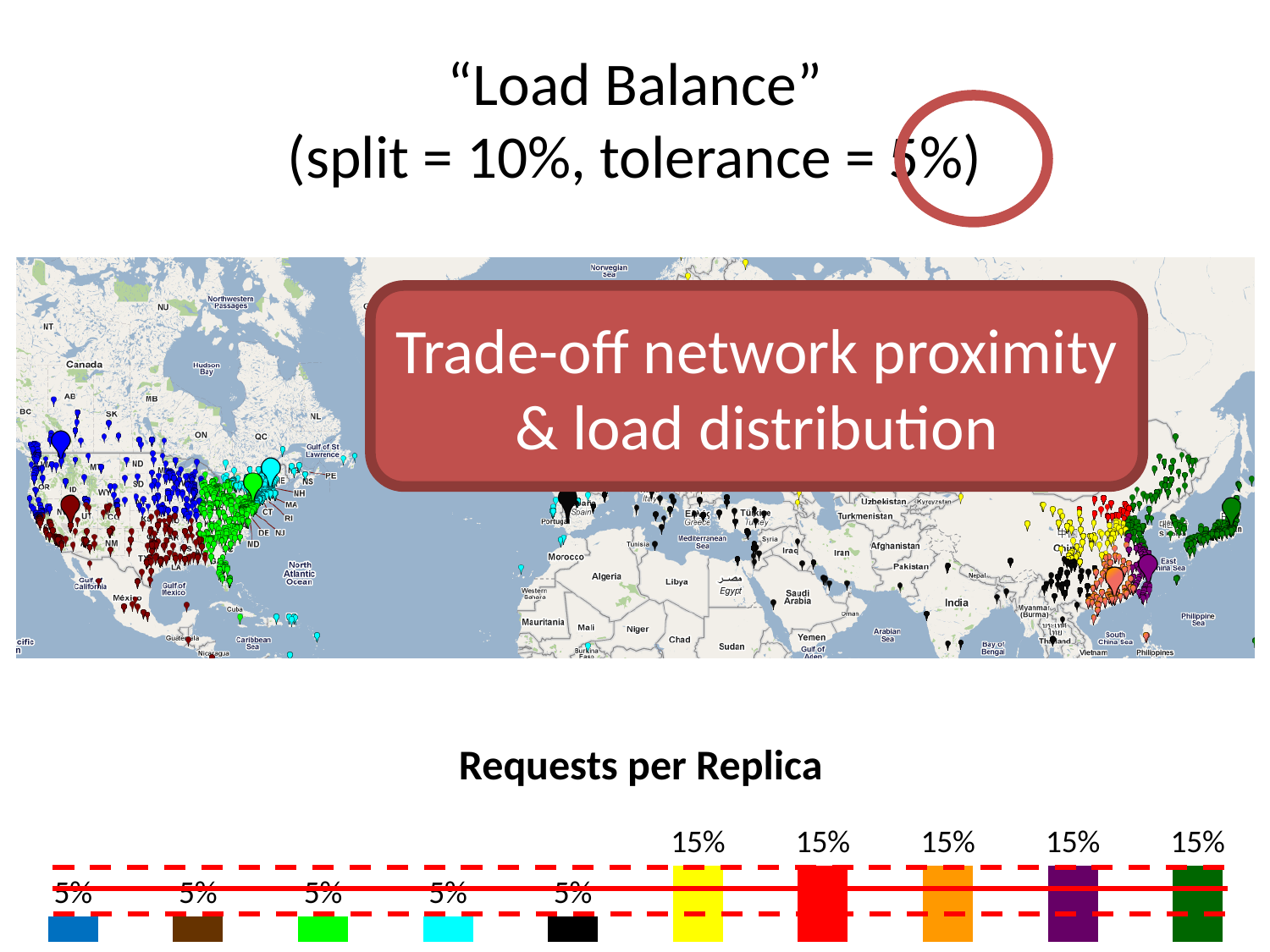
In the "Requests per Replica" chart, how many bars are labelled 15%? 5 In the "Requests per Replica" chart, what is the difference between the yellow bar and the cyan bar? 10% In the "Requests per Replica" chart, what value is labelled on the blue bar at the far left? 5% In the "Requests per Replica" chart, what is the total of the five bars labelled 5%? 25% In the "Requests per Replica" chart, which is larger, the orange bar or the brown bar? the orange bar In the "Requests per Replica" chart, how many bars are plotted? 10 What kind of chart is shown under the heading "Requests per Replica"? bar chart In the "Requests per Replica" chart, what value is labelled on the purple bar? 15% What is the title of the bar chart at the bottom of the slide? Requests per Replica In the "Requests per Replica" chart, what value is labelled on the black bar? 5% In the "Requests per Replica" chart, what value is labelled on the red bar? 15% In the "Requests per Replica" chart, how many bars are labelled 5%? 5